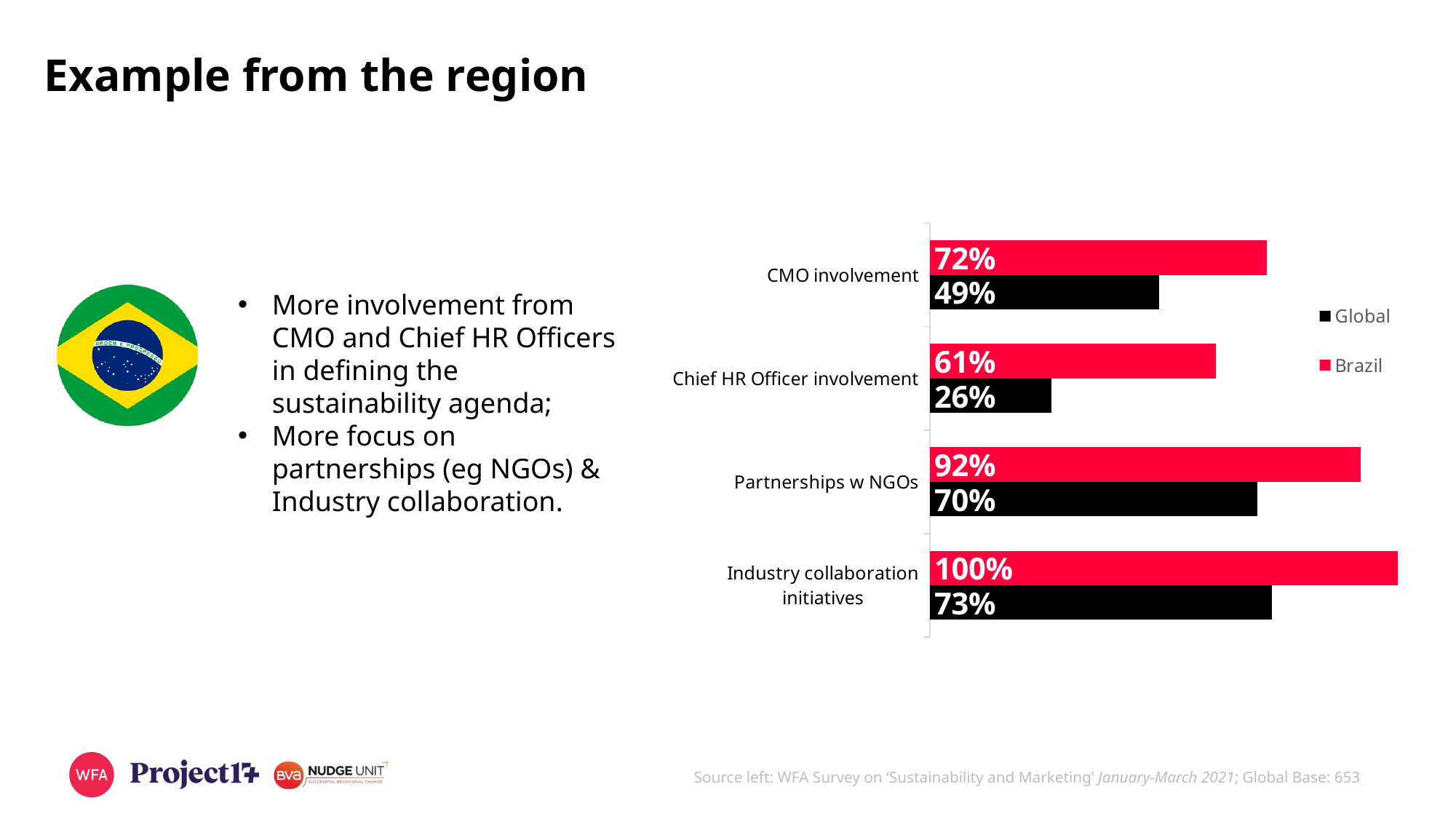
What is the difference between the Brazil and Global values for Chief HR Officer involvement? 35% What kind of chart is shown on the slide? Bar chart What is the Global value for Partnerships w NGOs? 70% What is the Brazil value for CMO involvement? 72% Which is larger for Partnerships w NGOs, the Brazil value or the Global value? Brazil Which category has the highest Brazil value? Industry collaboration initiatives How many categories are shown in the chart? 4 What is the Global value for Chief HR Officer involvement? 26% How many series does the legend list? 2 Which category has the lowest Global value? Chief HR Officer involvement What is the Brazil value for Industry collaboration initiatives? 100% What is the difference between the Brazil and Global values for Industry collaboration initiatives? 27%